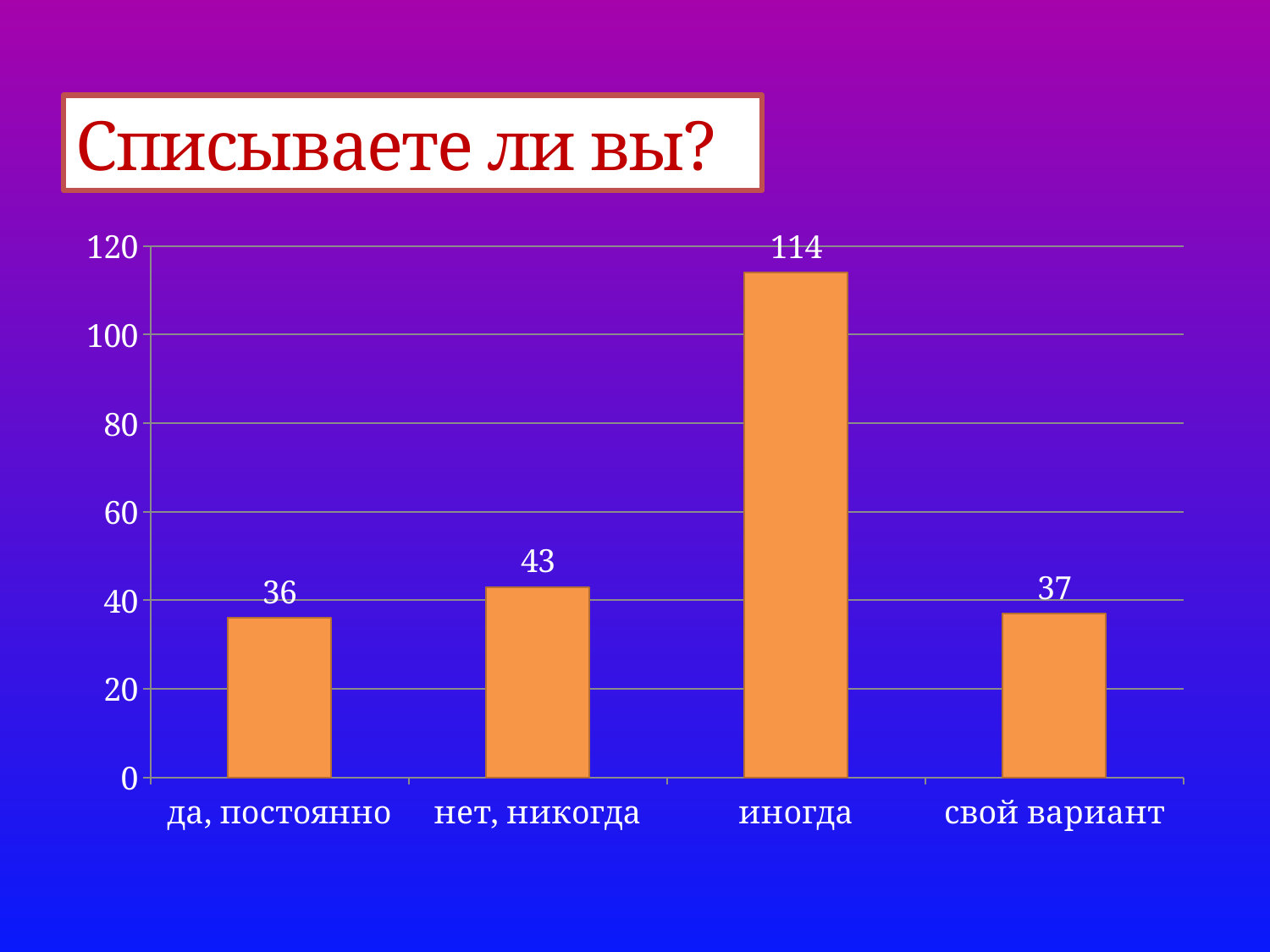
What kind of chart is shown on the slide? bar chart Which category has the lowest value? да, постоянно How many categories are shown on the x axis? 4 What is the value for "нет, никогда"? 43 What is the value for "да, постоянно"? 36 What is the value for "свой вариант"? 37 What is the title of the slide above the chart? Списываете ли вы? Which is larger, the value for "нет, никогда" or the value for "свой вариант"? нет, никогда Which category has the highest value? иногда What is the value for "иногда"? 114 What is the difference between the values for "иногда" and "нет, никогда"? 71 What is the difference between the values for "свой вариант" and "да, постоянно"? 1